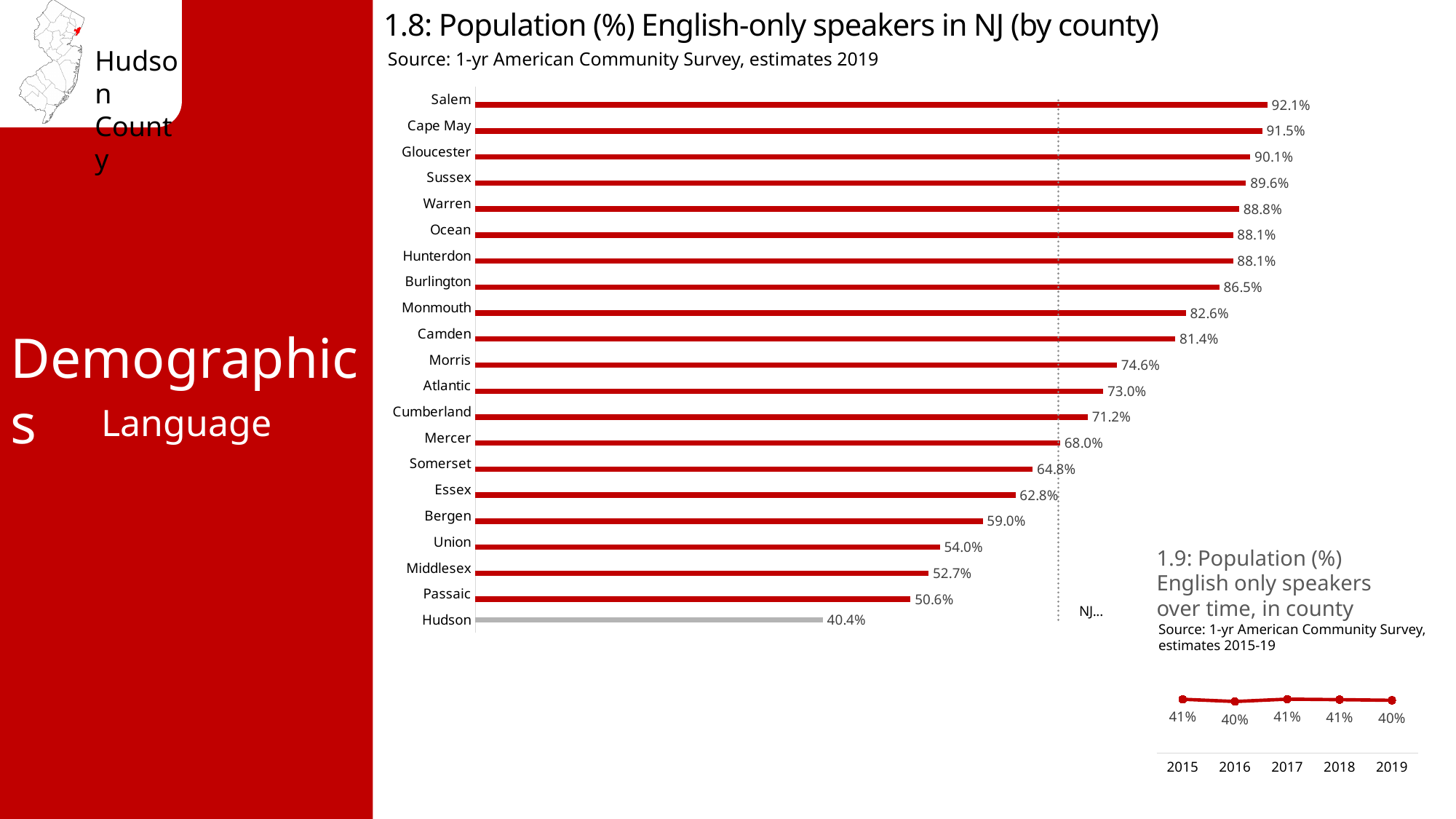
In chart 1.8 (English-only speakers by county), what is the difference between Salem and Hudson? 51.7% In chart 1.9 (English only speakers over time), how many years are plotted? 5 In chart 1.9 (English only speakers over time), what is the value for 2016? 40% In chart 1.8 (English-only speakers by county), what is the value for Bergen? 59.0% In chart 1.8 (English-only speakers by county), which county has the highest value? Salem In chart 1.8 (English-only speakers by county), how many counties are shown? 21 What kind of chart is chart 1.9 (English only speakers over time)? Line chart In chart 1.8 (English-only speakers by county), what is the value for Hudson? 40.4% In chart 1.9 (English only speakers over time), what is the value for 2019? 40% In chart 1.8 (English-only speakers by county), which is larger, the value for Morris or the value for Mercer? Morris What kind of chart is chart 1.8 (English-only speakers by county)? Bar chart In chart 1.8 (English-only speakers by county), which county has the lowest value? Hudson